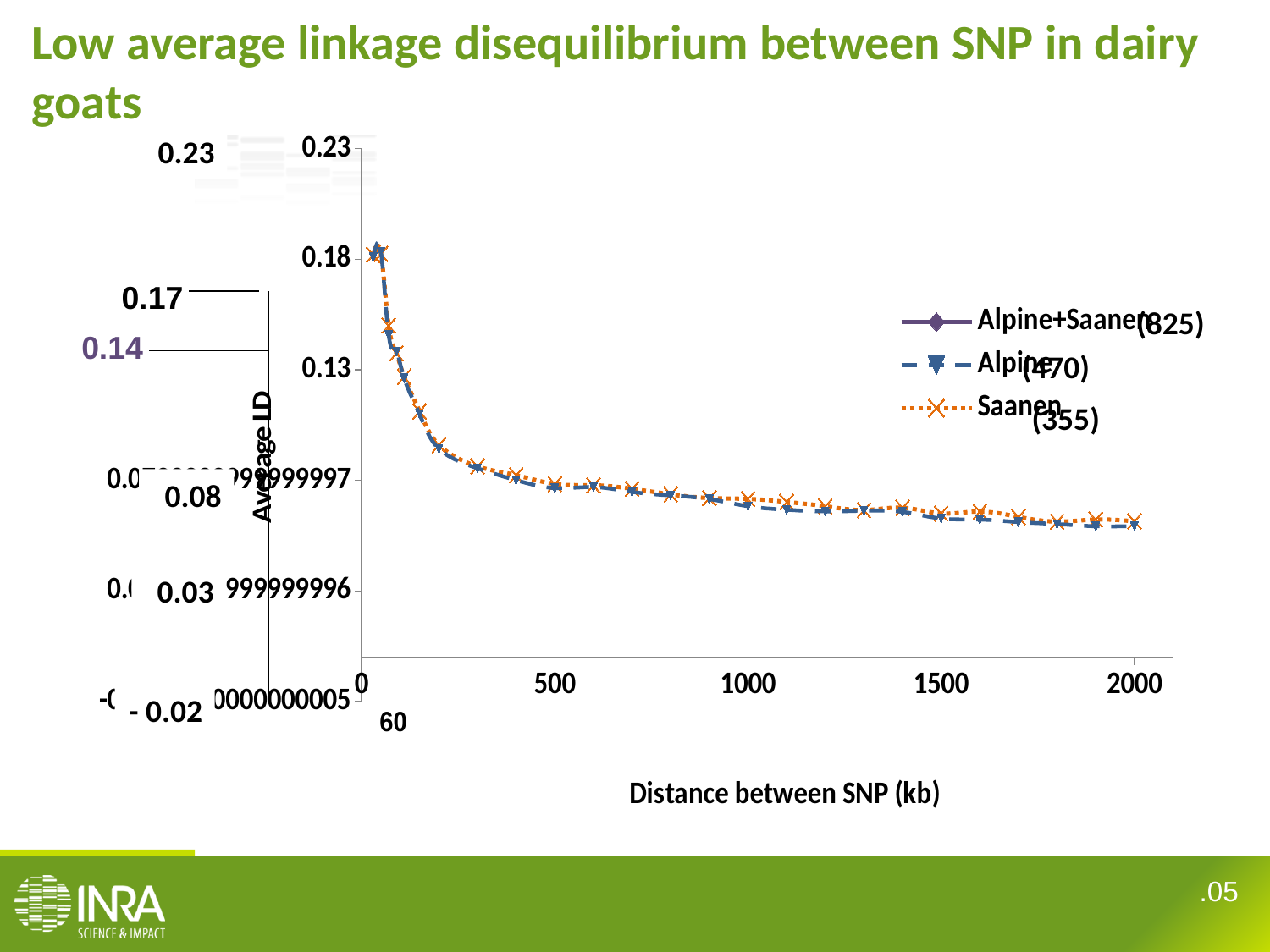
What is the title of the y axis of the chart? Average LD Is the Average LD for Alpine+Saanen at a distance of 500 kb greater or less than 0.13? less Is the Average LD for Saanen at a distance of 1000 kb greater or less than 0.03? greater Is the Average LD for Alpine at a distance of 2000 kb greater or less than 0.08? less What is the highest value shown on the x axis of the chart? 2000 How many series does the chart legend list? 3 What kind of chart is shown on the slide? line chart Do the Average LD values rise or fall as the distance between SNP increases? fall What is the title of the x axis of the chart? Distance between SNP (kb)